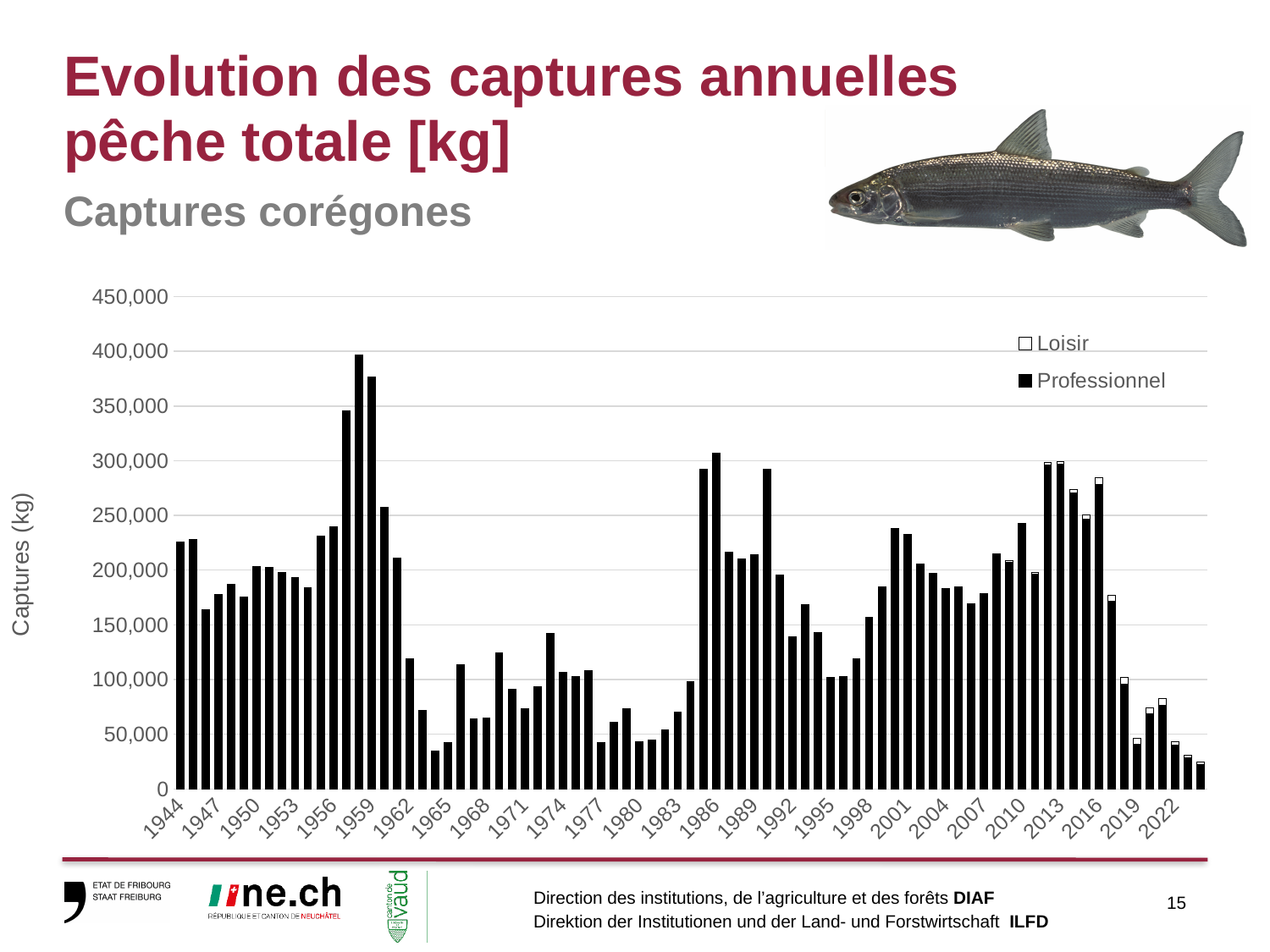
Which year has the larger total catch, 2013 or 2022? 2013 What are the two series named in the legend? Loisir and Professionnel Do the catches rise or fall from 2016 to 2022? fall Is the value for 2022 greater or less than 100,000? less Is the value for 1980 greater or less than 100,000? less Which year has the highest total catch? 1958 Is the value for 1944 greater or less than 200,000? greater How many series does the legend list? 2 What is the label of the vertical axis? Captures (kg) What kind of chart is shown on the slide? bar chart